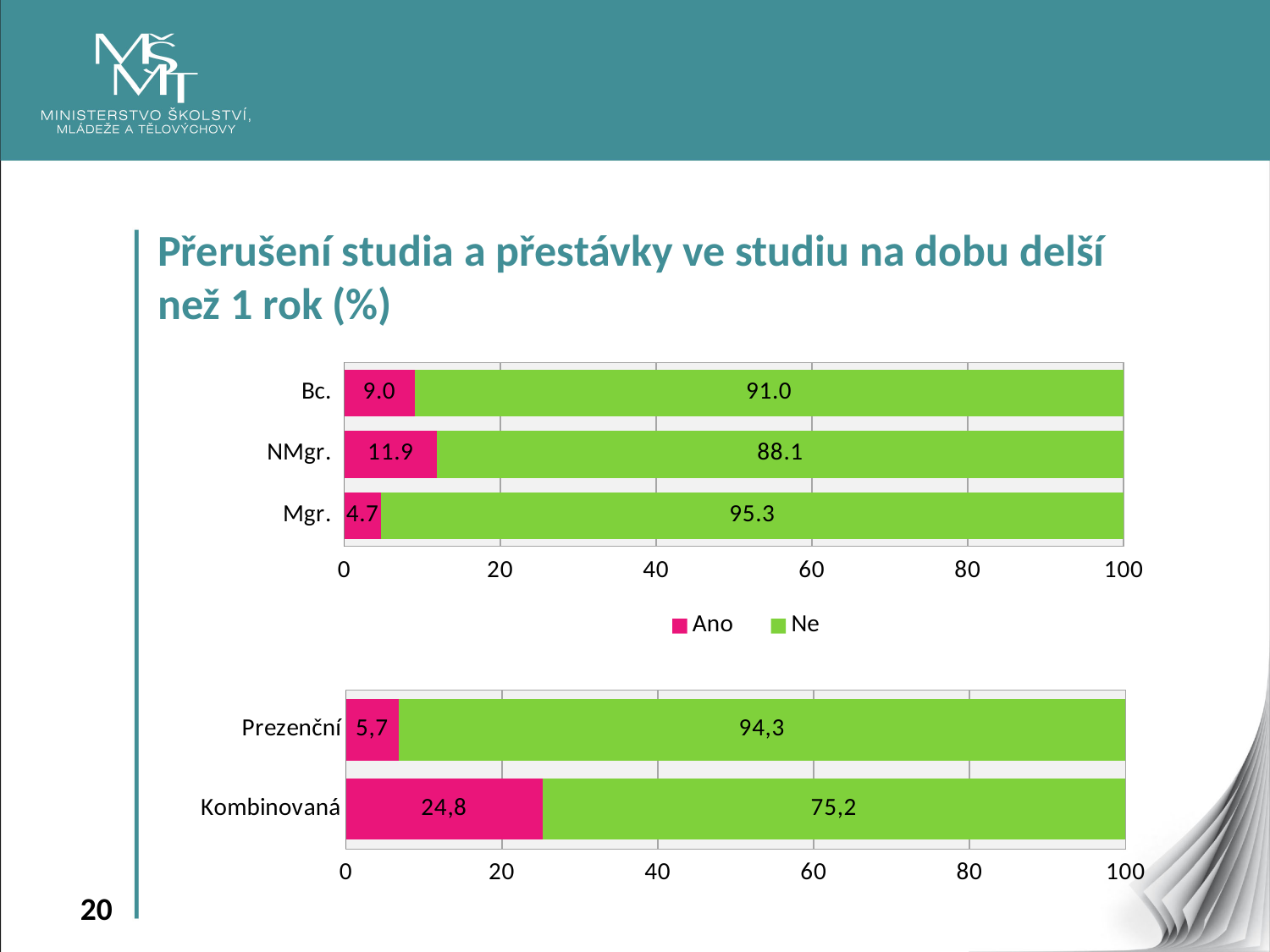
In the bottom chart, what is the value for Ano for Kombinovaná? 24,8 In the bottom chart, what is the value for Ne for Prezenční? 94,3 In the bottom chart, what is the difference between the Ano values for Kombinovaná and Prezenční? 19,1 How many series does the legend list? 2 In the top chart, what is the difference between the Ano values for NMgr. and Bc.? 2.9 What type of chart is the bottom chart? Stacked bar chart In the top chart, what is the value for Ne for Mgr.? 95.3 In the top chart, what is the value for Ano for NMgr.? 11.9 In the top chart, which category has the lowest Ano value? Mgr. In the top chart, which category has the highest Ano value? NMgr. How many categories are shown in the top chart? 3 In the bottom chart, which has the larger Ne value, Prezenční or Kombinovaná? Prezenční